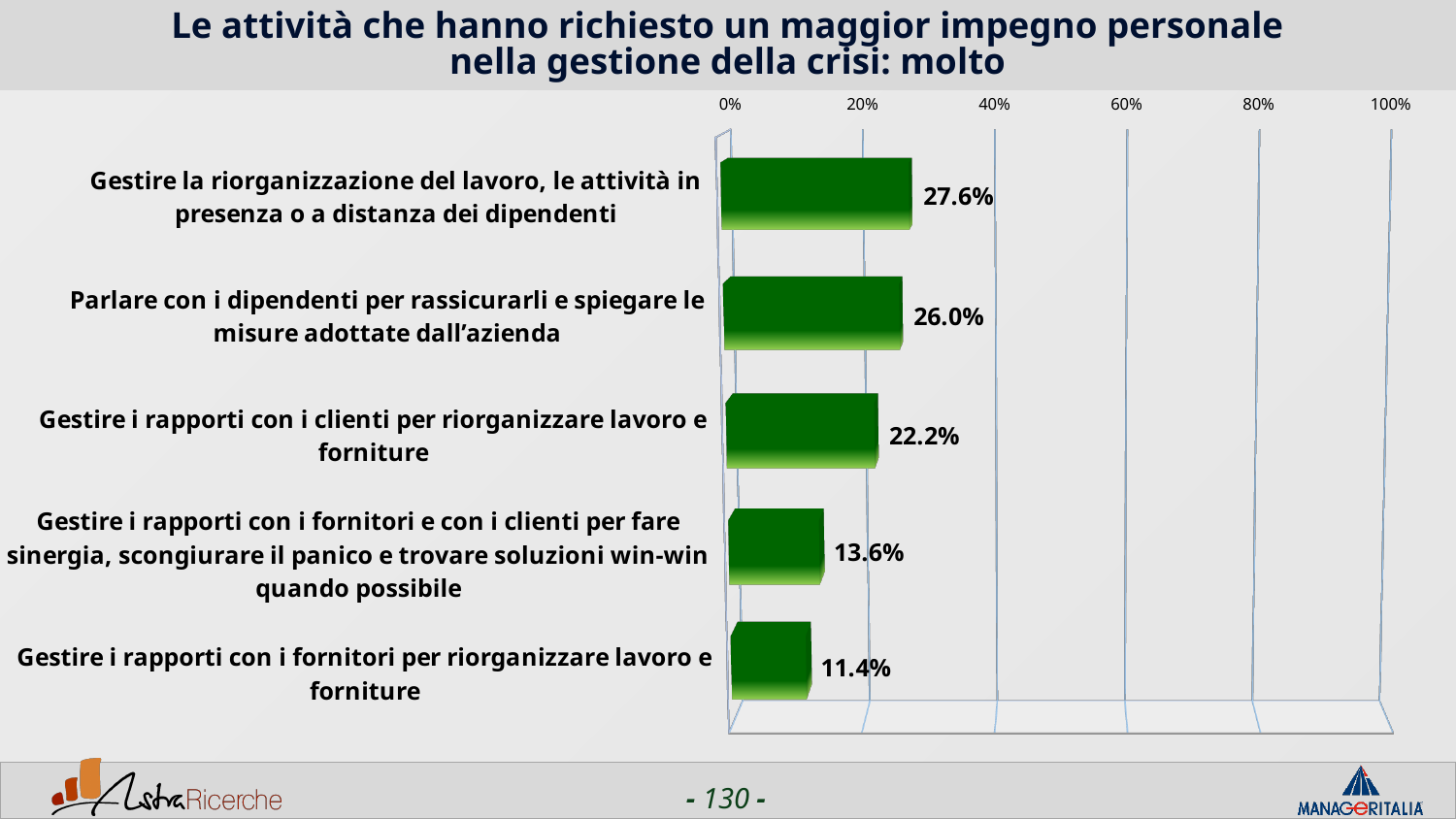
What colour are the bars in the chart? Green What is the value for "Gestire la riorganizzazione del lavoro, le attività in presenza o a distanza dei dipendenti"? 27.6% Which is larger: the value for "Gestire i rapporti con i clienti per riorganizzare lavoro e forniture" or the value for "Gestire i rapporti con i fornitori e con i clienti per fare sinergia, scongiurare il panico e trovare soluzioni win-win quando possibile"? Gestire i rapporti con i clienti per riorganizzare lavoro e forniture Which category has the highest value? Gestire la riorganizzazione del lavoro, le attività in presenza o a distanza dei dipendenti What is the value for "Gestire i rapporti con i fornitori per riorganizzare lavoro e forniture"? 11.4% How many categories are shown in the chart? 5 Which category has the lowest value? Gestire i rapporti con i fornitori per riorganizzare lavoro e forniture Is the value for "Gestire la riorganizzazione del lavoro, le attività in presenza o a distanza dei dipendenti" greater or less than 20%? greater What kind of chart is shown on the slide? Bar chart What is the maximum value shown on the percentage axis? 100% What is the value for "Parlare con i dipendenti per rassicurarli e spiegare le misure adottate dall'azienda"? 26.0% What is the difference between the values for "Gestire i rapporti con i clienti per riorganizzare lavoro e forniture" and "Gestire i rapporti con i fornitori per riorganizzare lavoro e forniture"? 10.8%